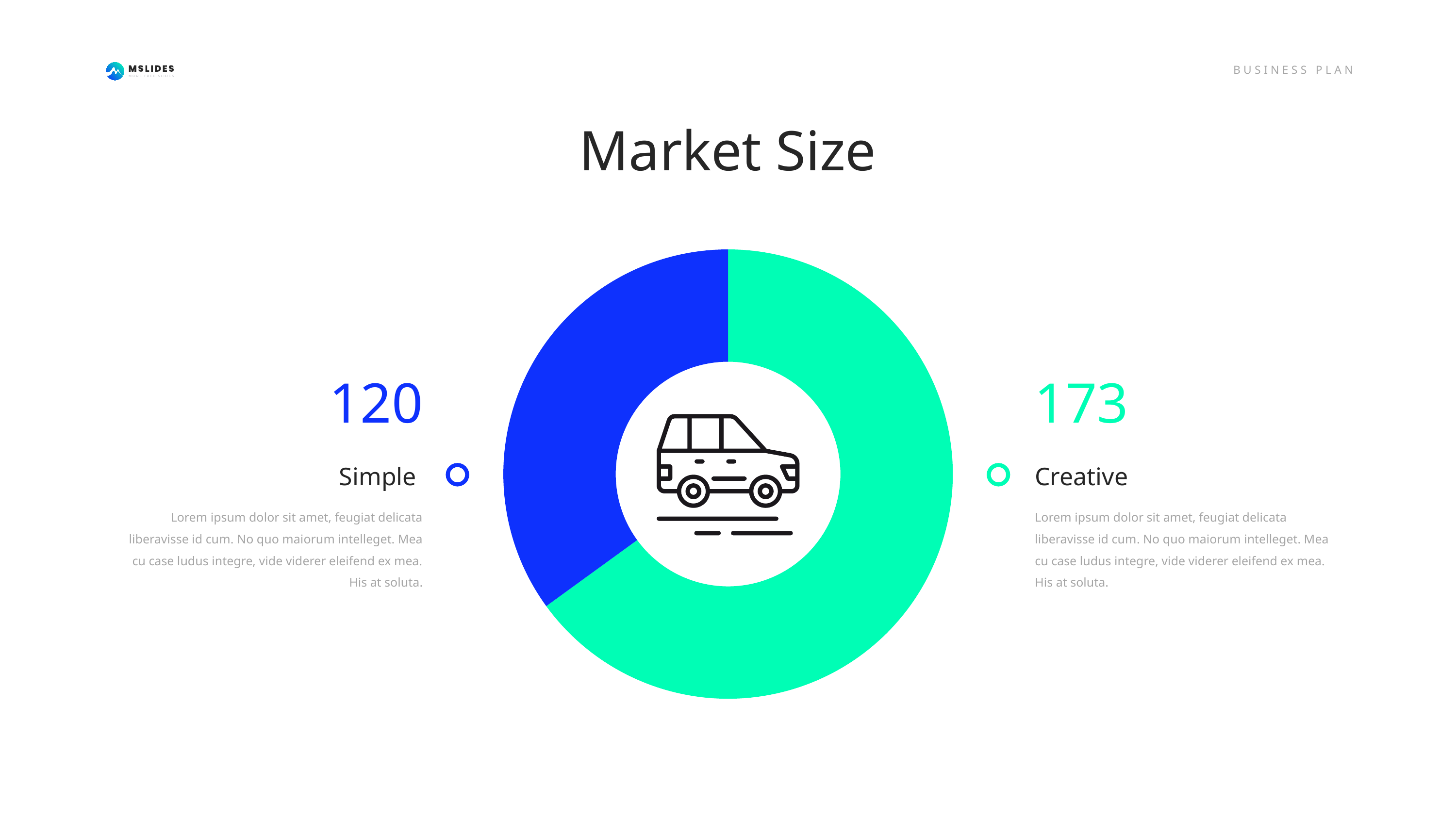
How many categories are shown in the Market Size chart? 2 What is the combined total of the Simple and Creative values in the Market Size chart? 293 What colour represents the Simple category in the Market Size chart? Blue What is the value for Simple in the Market Size chart? 120 Which category has the largest segment in the Market Size chart? Creative Which category has the smallest segment in the Market Size chart? Simple Which is larger in the Market Size chart, Simple or Creative? Creative What is the title of the slide containing the chart? Market Size What is the difference between the Creative and Simple values in the Market Size chart? 53 What is the value for Creative in the Market Size chart? 173 What kind of chart is shown on the slide? Donut chart